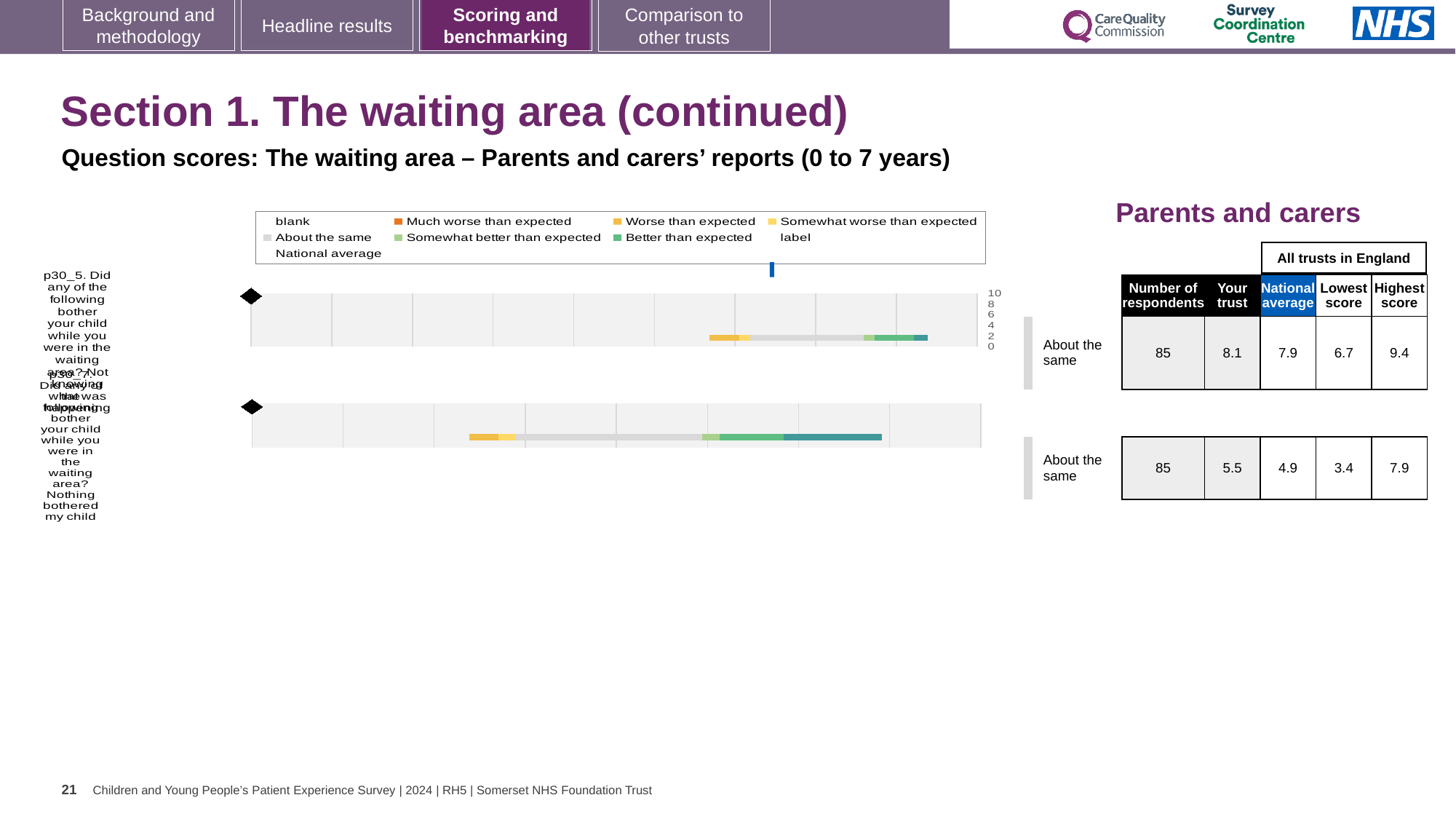
For the bottom chart (p30_7), what is the difference between the highest score and the lowest score across all trusts in England? 4.5 How many entries does the chart legend list? 9 For the top chart (p30_5), what is the difference between the 'Your trust' score and the national average? 0.2 Which legend entry is represented by a blue marker? National average What colour does the legend use for 'Much worse than expected'? orange For the bottom chart (p30_7, Nothing bothered my child), what is the national average score shown in the table? 4.9 What kind of chart is used to show the question scores on this slide? bar chart How many separate question charts are plotted on the slide? 2 How many respondents are listed for the top chart (p30_5)? 85 For the bottom chart (p30_7), which is larger: the 'Your trust' score or the national average? Your trust For the top chart (p30_5, Not knowing what was happening), what is the 'Your trust' score shown in the table? 8.1 What is the highest tick value shown on the chart axis? 10